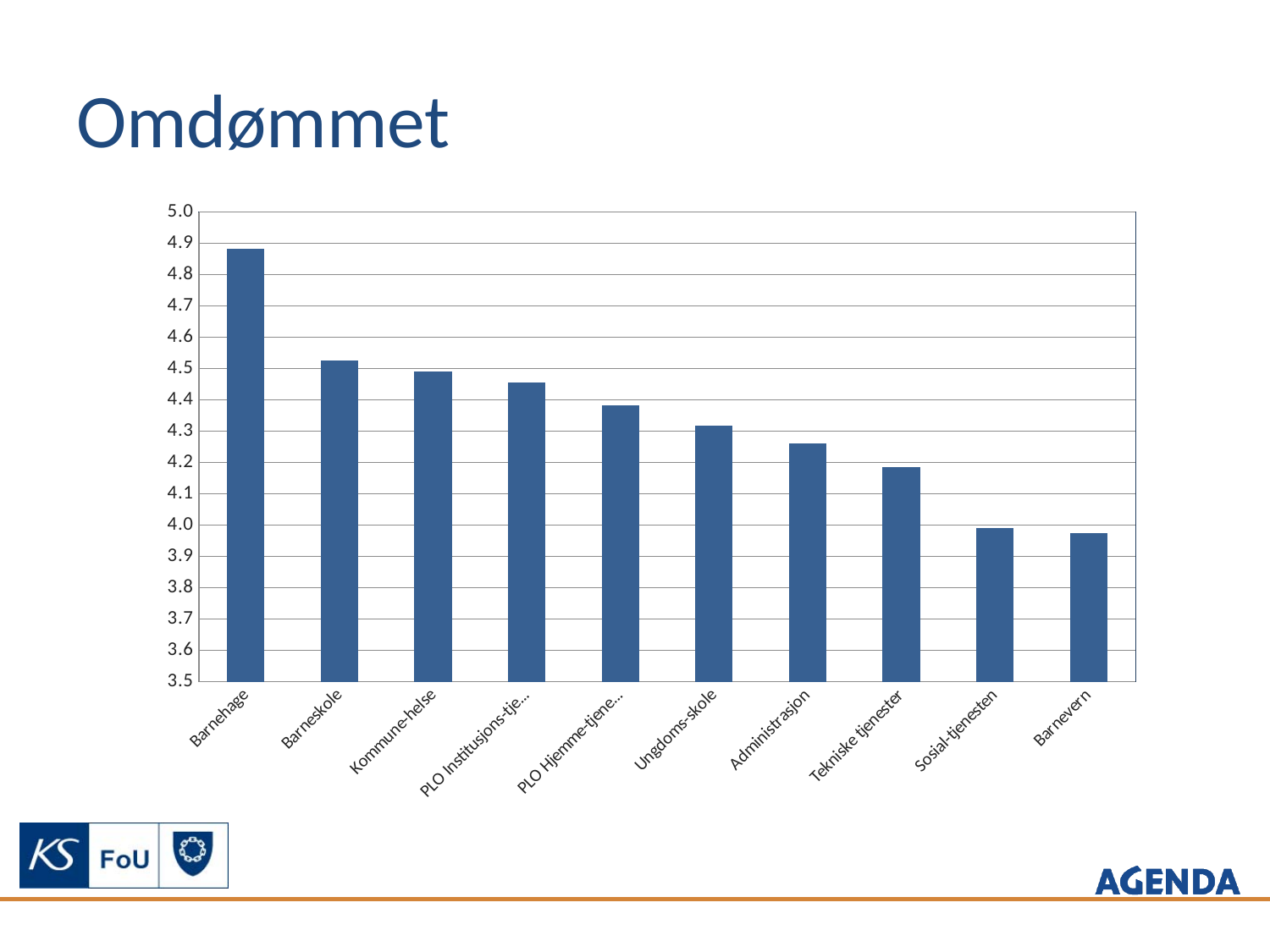
Which is larger, the value for Administrasjon or the value for Tekniske tjenester? Administrasjon What is the title of the chart on the slide? Omdømmet How many categories are plotted on the x axis? 10 Which category has the highest value? Barnehage Is the value for Barneskole greater or less than 4.4? greater Which is larger, the value for Barnehage or the value for Barneskole? Barnehage Is the value for Barnevern greater or less than 4.1? less Is the value for Barnehage greater or less than 4.8? greater What kind of chart is shown on the slide? bar chart Do the values rise or fall from left to right along the x axis? fall